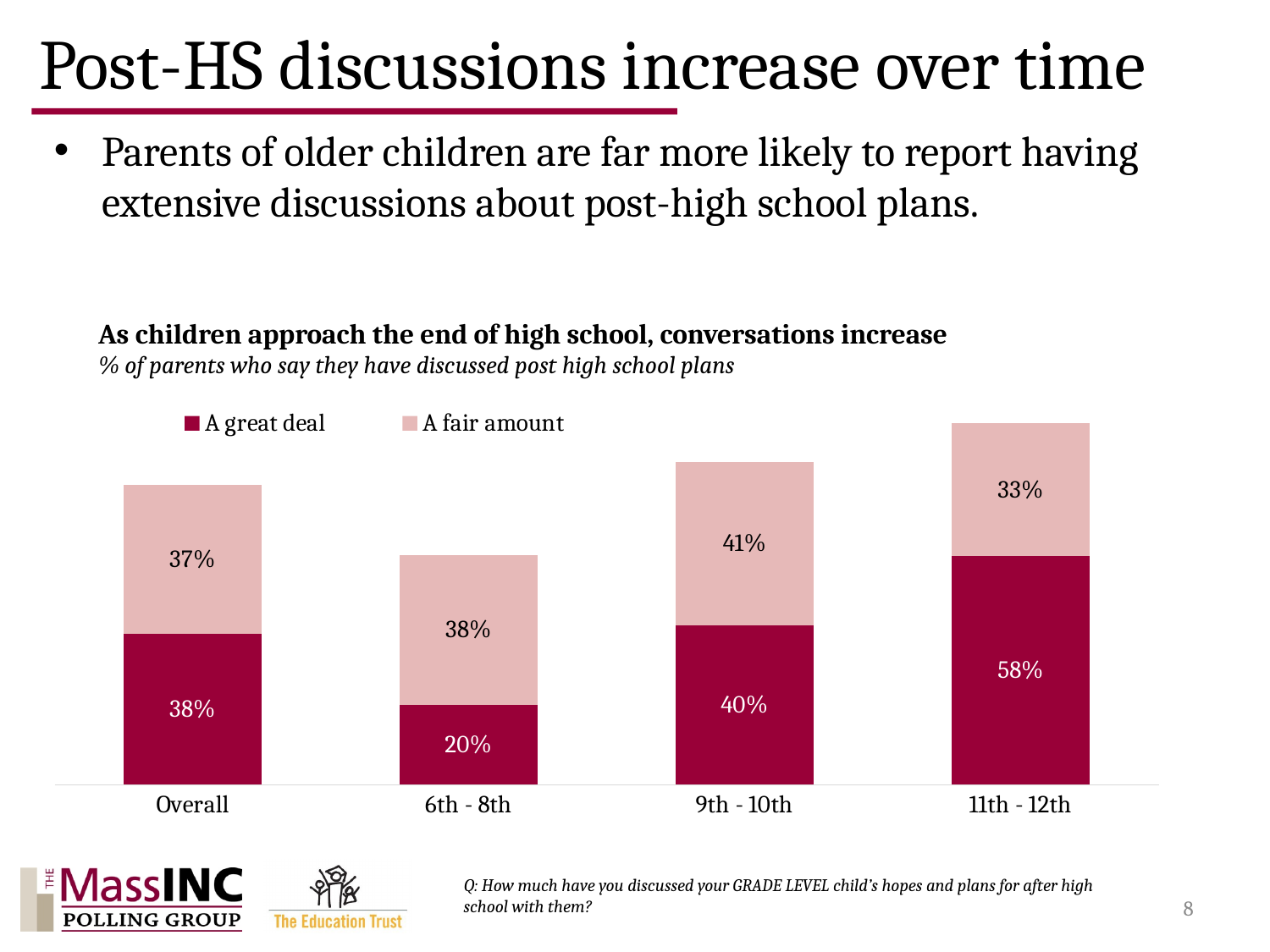
Which category has the lowest 'A great deal' value? 6th - 8th What is the difference between the 'A great deal' values for 11th - 12th and 6th - 8th? 38% What is the 'A fair amount' value for the 9th - 10th category? 41% What percentage of parents in the 11th - 12th group say they have discussed post high school plans 'A great deal'? 58% How many series does the legend list? 2 What kind of chart is shown on the slide? Stacked bar chart How many categories are shown on the x axis? 4 What is the total of the stacked bar for 9th - 10th? 81% Which category has the highest 'A great deal' value? 11th - 12th What is the 'A great deal' value for the 6th - 8th category? 20% Which is larger: the 'A fair amount' value for Overall or for 11th - 12th? Overall What is the title of the chart? As children approach the end of high school, conversations increase